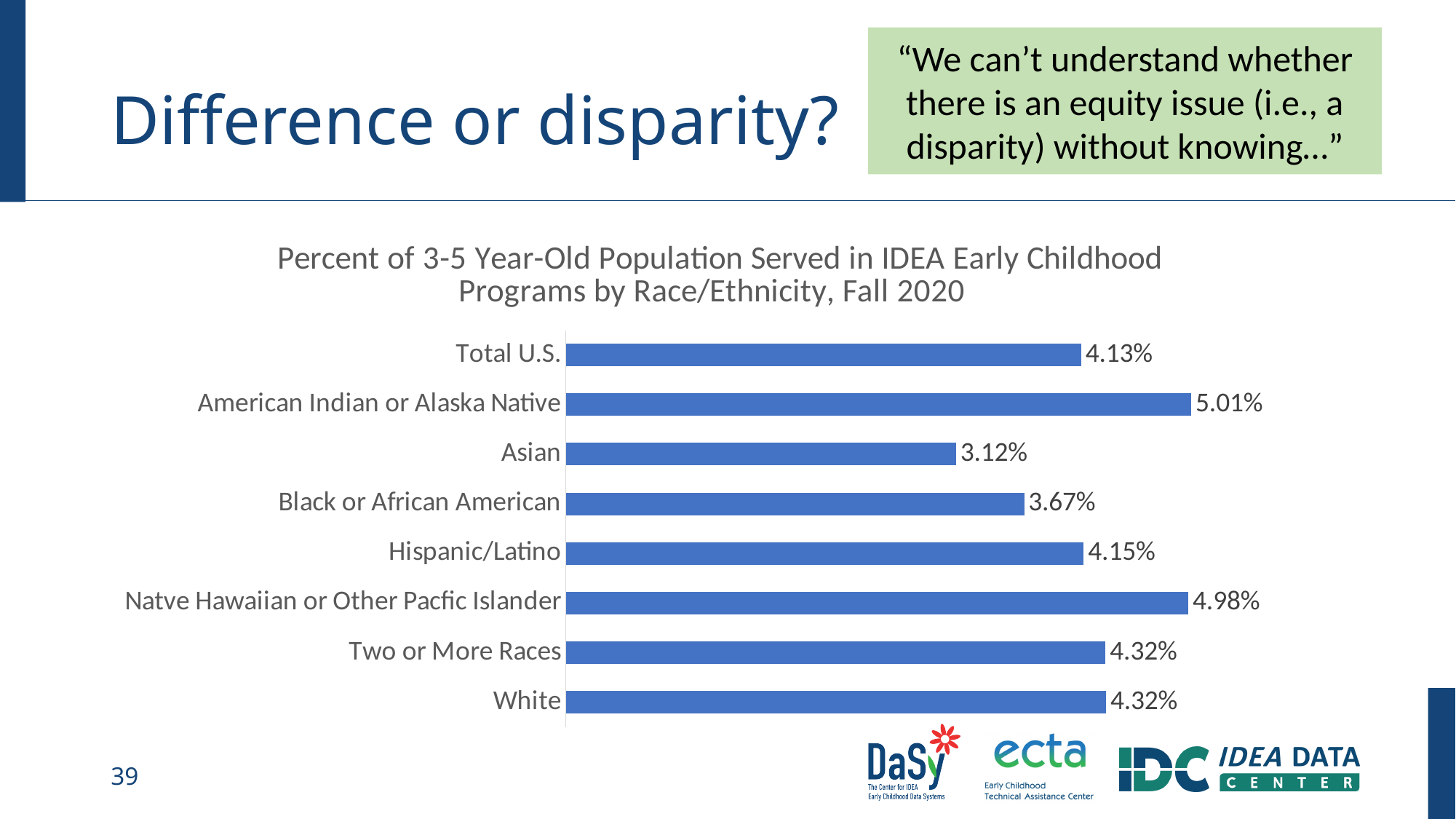
What is the difference between the values for American Indian or Alaska Native and Asian? 1.89% What is the difference between the values for White and Black or African American? 0.65% What is the value for Black or African American? 3.67% Which category has the highest value? American Indian or Alaska Native What kind of chart is shown on the slide? Bar chart What is the value for Total U.S.? 4.13% What is the title of the chart? Percent of 3-5 Year-Old Population Served in IDEA Early Childhood Programs by Race/Ethnicity, Fall 2020 How many categories are shown in the chart? 8 Which is larger, the value for Hispanic/Latino or the value for Black or African American? Hispanic/Latino What is the value for Native Hawaiian or Other Pacific Islander? 4.98% What is the value for Asian? 3.12% Which category has the lowest value? Asian